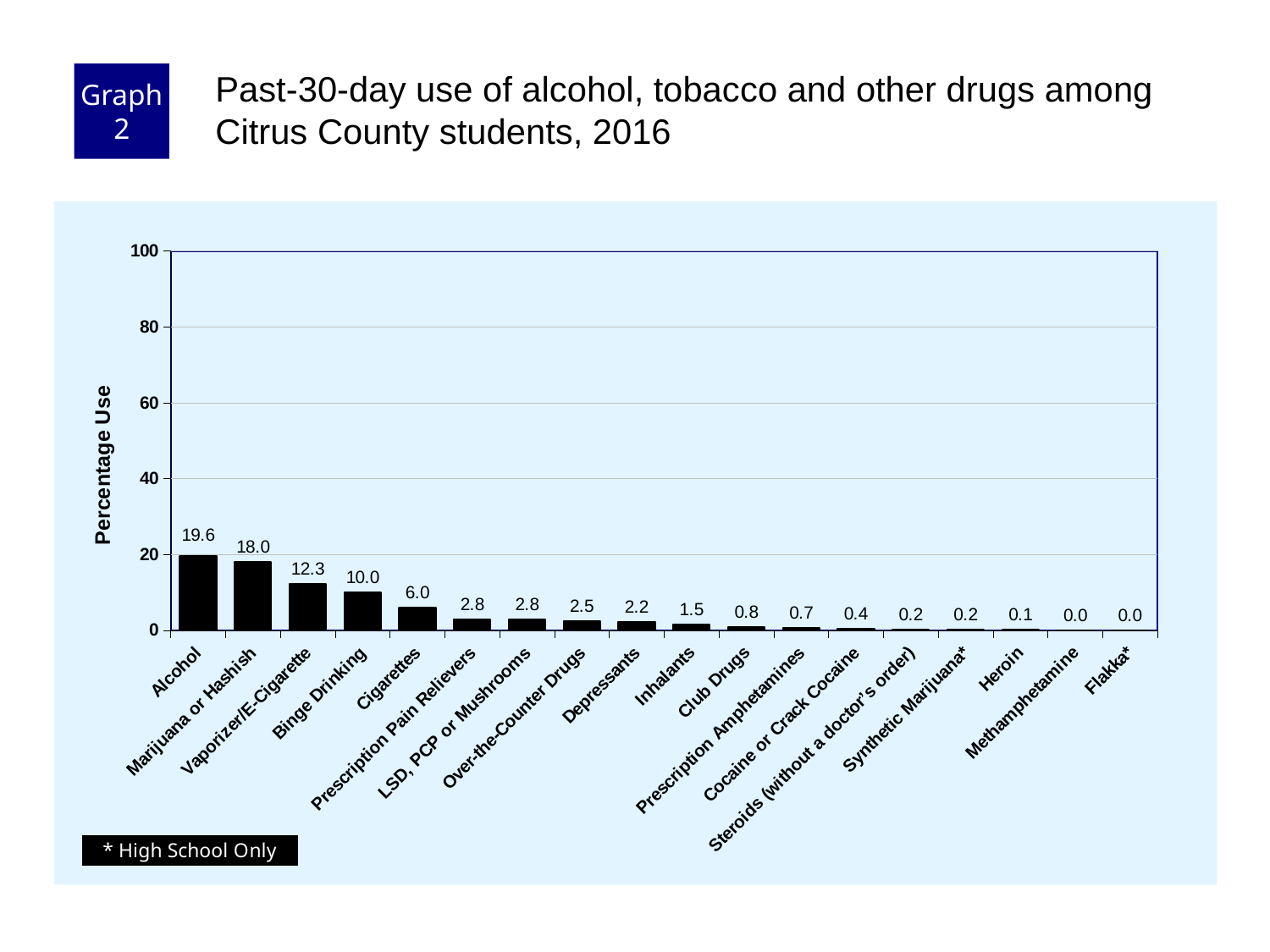
Which category has the highest percentage use? Alcohol Which has a higher percentage use, Depressants or Over-the-Counter Drugs? Over-the-Counter Drugs What is the percentage use for Heroin? 0.1 What is the percentage use for Inhalants? 1.5 What is the difference in percentage use between Binge Drinking and Cigarettes? 4.0 What is the percentage use for Cigarettes? 6.0 What is the percentage use for Vaporizer/E-Cigarette? 12.3 What is the difference in percentage use between Alcohol and Marijuana or Hashish? 1.6 What is the percentage use for Alcohol? 19.6 What is the label of the y axis? Percentage Use How many categories are shown on the x axis? 18 What kind of chart is shown on the slide? Bar chart